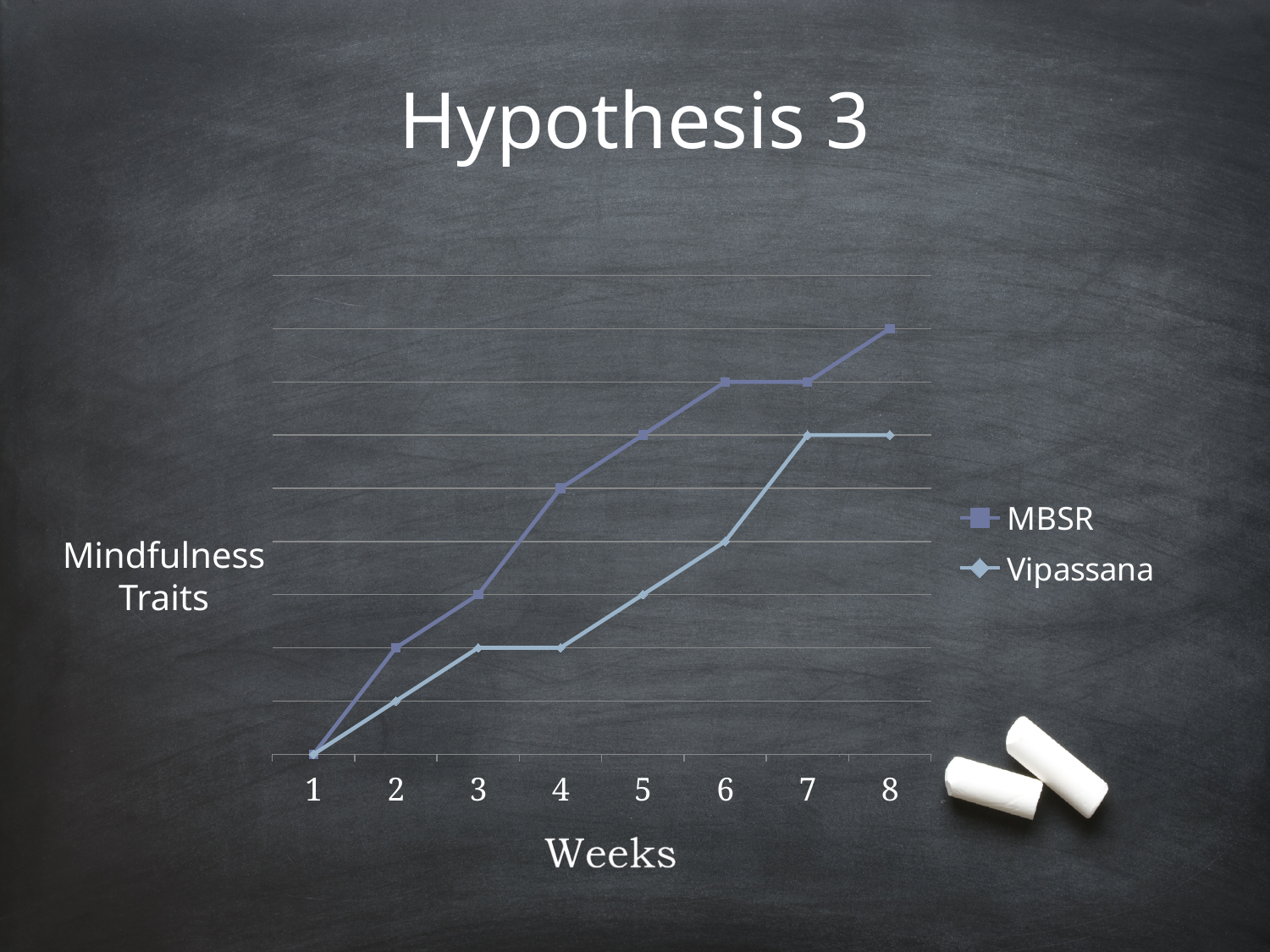
Do the Vipassana values rise or fall from week 1 to week 8? rise At which week does the MBSR series reach its highest value? 8 What is the label on the x axis of the chart? Weeks How many series does the legend list? 2 For the Vipassana series, is the value at week 6 higher or lower than at week 3? higher At week 4, which series has the higher value, MBSR or Vipassana? MBSR At which week does the Vipassana series have its lowest value? 1 What kind of chart is shown on the slide? line chart At week 6, which series has the higher value, MBSR or Vipassana? MBSR Do the MBSR values rise or fall from week 1 to week 8? rise What is the title of the slide containing the chart? Hypothesis 3 How many weeks are plotted along the x axis? 8